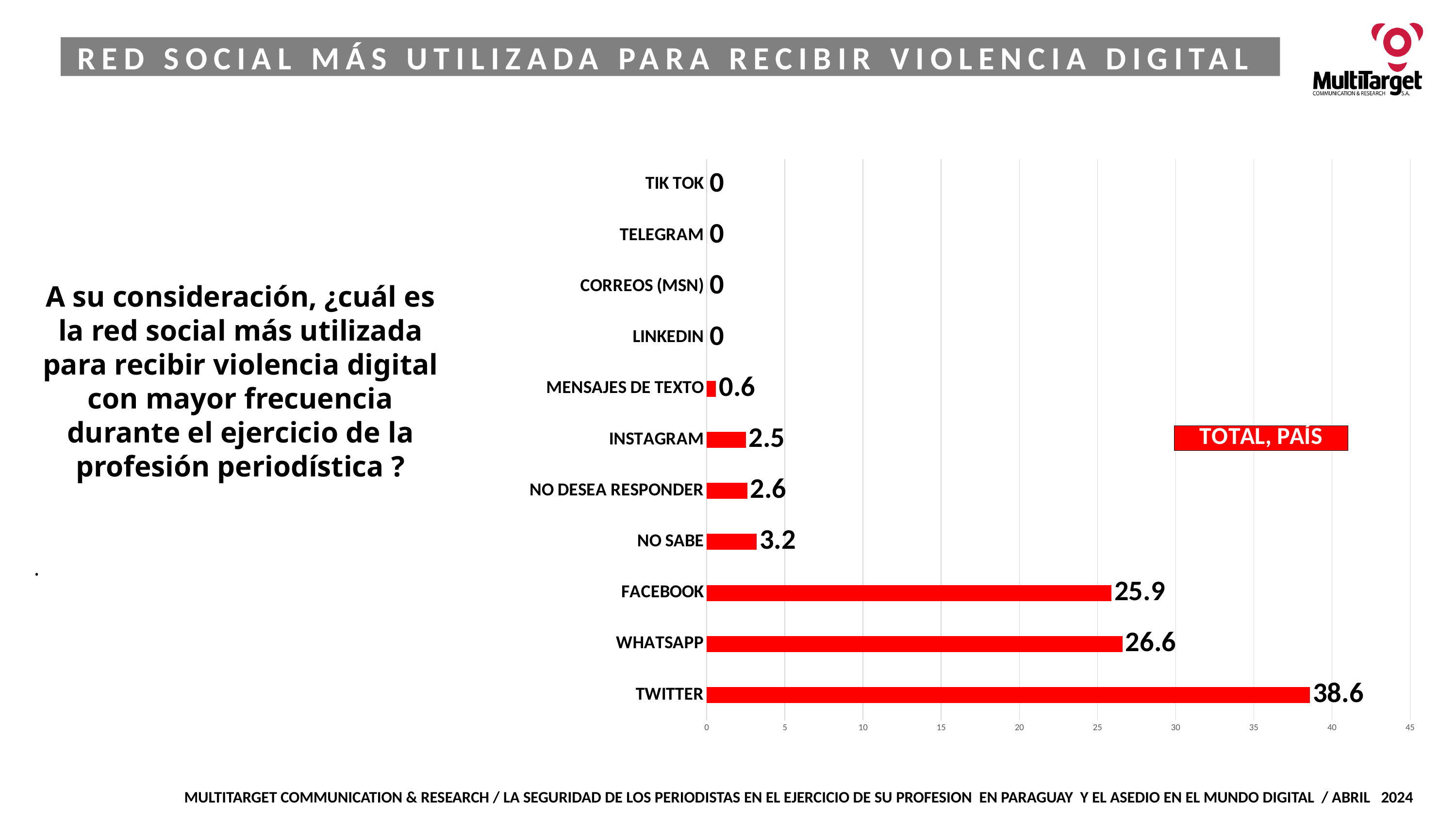
What is the difference between the values for WHATSAPP and FACEBOOK? 0.7 How many categories are shown on the chart? 11 Which is larger, the value for NO SABE or the value for INSTAGRAM? NO SABE What is the value for MENSAJES DE TEXTO? 0.6 Is the value for TWITTER greater or less than 35? greater How many categories have a value of 0? 4 What is the difference between the values for TWITTER and WHATSAPP? 12 What is the value for NO SABE? 3.2 What is the value for FACEBOOK? 25.9 What kind of chart is shown on the slide? bar chart Which category has the highest value? TWITTER What is the value for TWITTER? 38.6